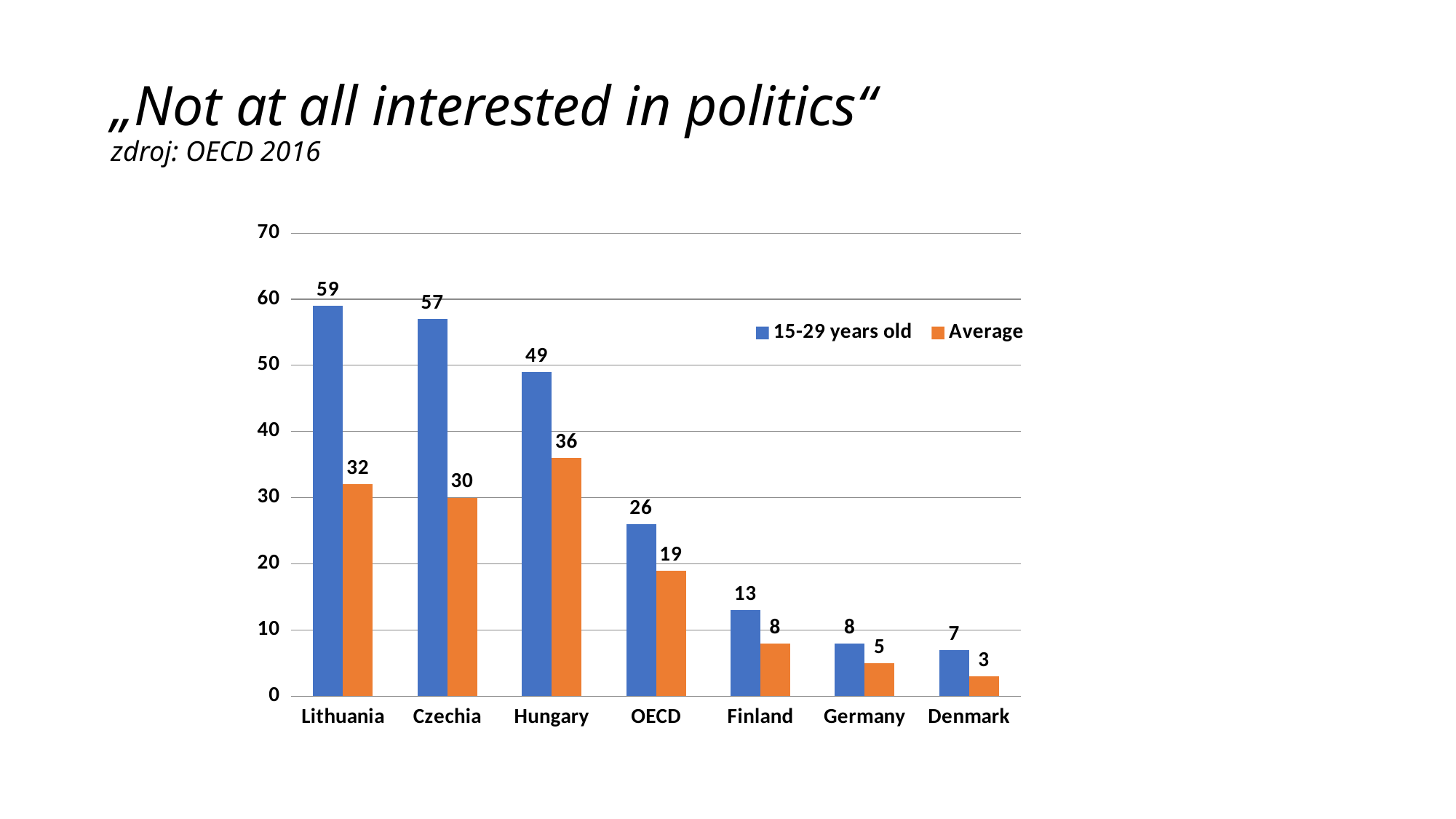
What is the difference between the 15-29 years old value and the Average value for Czechia? 27 What is the Average value for Hungary? 36 Which category has the highest value for 15-29 years old? Lithuania Is the value for 15-29 years old in Finland greater or less than 10? greater What is the value for 15-29 years old for OECD? 26 How many categories are shown on the x axis? 7 What is the value for 15-29 years old in Lithuania? 59 Which is larger: the Average value for Hungary or the Average value for Lithuania? Hungary Which category has the lowest Average value? Denmark What kind of chart is shown on the slide? Bar chart How many series does the legend list? 2 Do the 15-29 years old values rise or fall from Lithuania to Denmark along the x axis? Fall